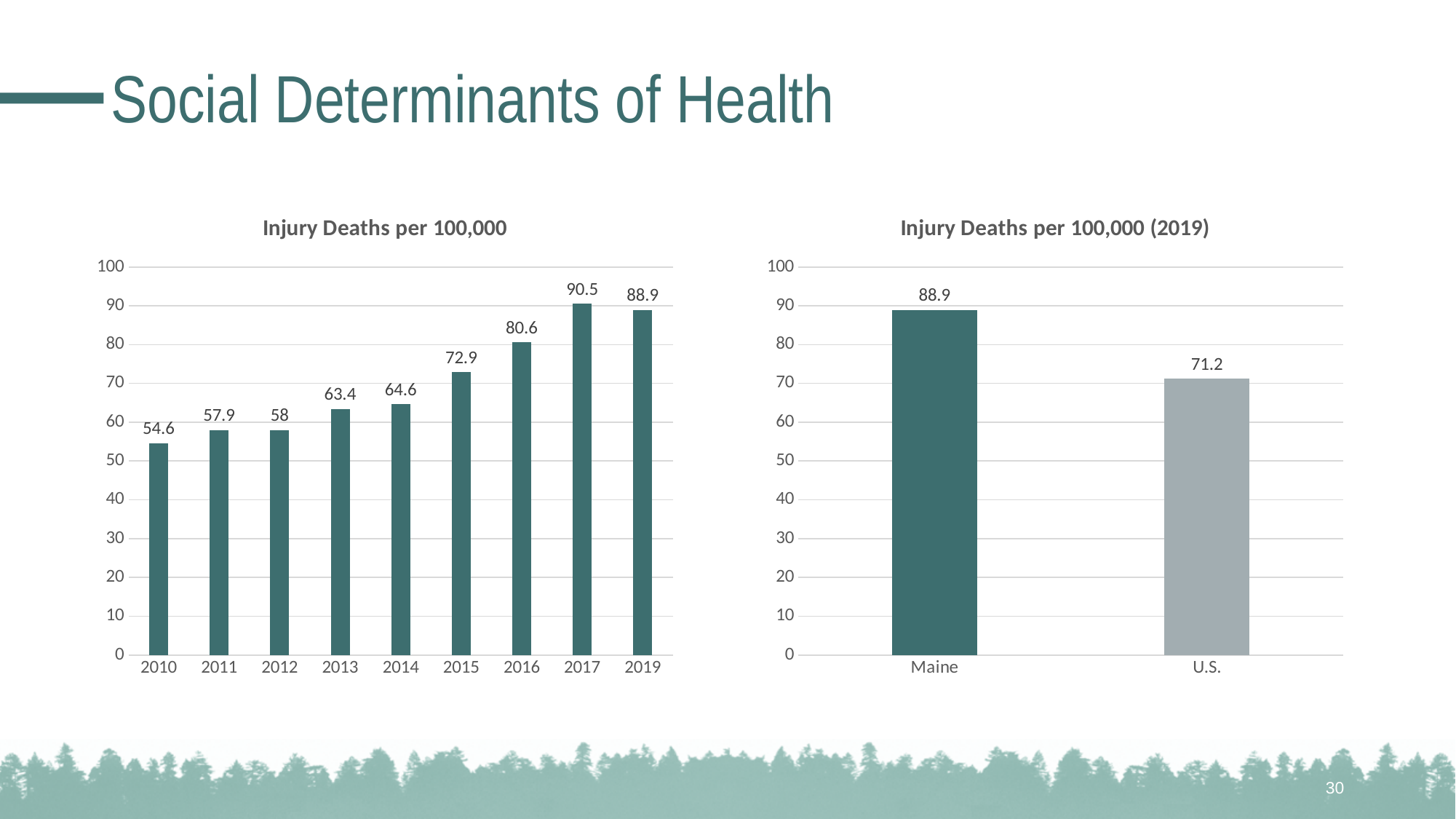
In the 'Injury Deaths per 100,000 (2019)' chart, which is larger, Maine or U.S.? Maine In the 'Injury Deaths per 100,000' chart, what is the difference between the values for 2017 and 2010? 35.9 In the 'Injury Deaths per 100,000' chart, what is the value for 2015? 72.9 In the 'Injury Deaths per 100,000' chart, how many years are shown on the x axis? 9 In the 'Injury Deaths per 100,000 (2019)' chart, what is the difference between Maine and the U.S.? 17.7 In the 'Injury Deaths per 100,000' chart, do the values generally rise or fall from 2010 to 2017? rise In the 'Injury Deaths per 100,000' chart, what is the value for 2012? 58 In the 'Injury Deaths per 100,000' chart, which year has the highest value? 2017 In the 'Injury Deaths per 100,000 (2019)' chart, what is the value for the U.S.? 71.2 In the 'Injury Deaths per 100,000' chart, is the value for 2016 greater or less than 80? greater What kind of chart is the 'Injury Deaths per 100,000 (2019)' chart? bar chart In the 'Injury Deaths per 100,000' chart, which year has the lowest value? 2010